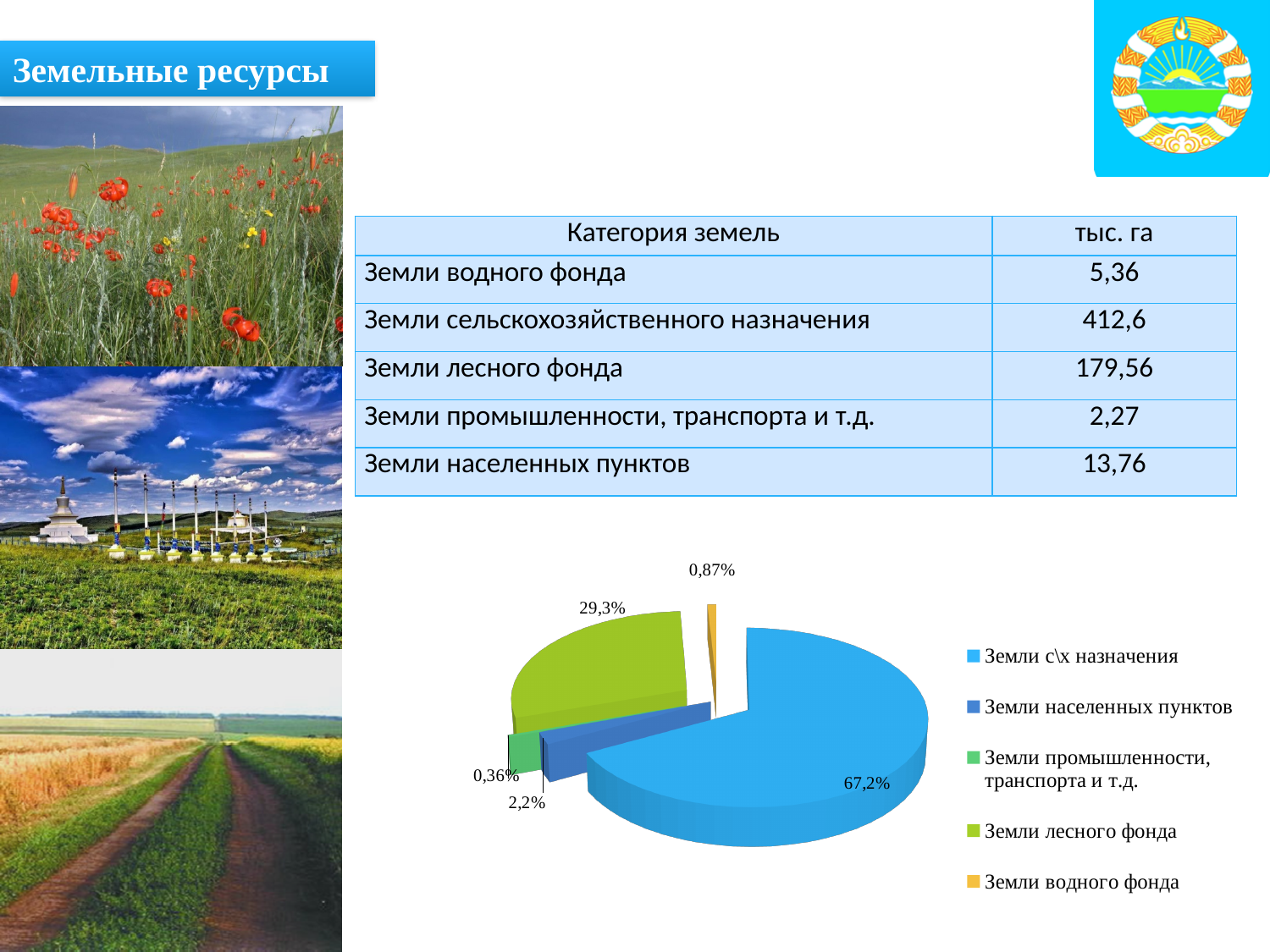
What colour is the "Земли лесного фонда" slice in the pie chart? green Which category has the smallest slice in the pie chart? Земли промышленности, транспорта и т.д. How many slices does the pie chart have? 5 What share of the pie chart does "Земли лесного фонда" have? 29,3% What share of the pie chart does "Земли водного фонда" have? 0,87% Which slice is larger in the pie chart: "Земли населенных пунктов" or "Земли водного фонда"? Земли населенных пунктов What kind of chart is shown on the slide? pie chart What share of the pie chart does "Земли промышленности, транспорта и т.д." have? 0,36% Which category has the largest slice in the pie chart? Земли с\х назначения What share of the pie chart does "Земли с\х назначения" have? 67,2% What share of the pie chart does "Земли населенных пунктов" have? 2,2% What is the difference in percentage points between the "Земли с\х назначения" slice and the "Земли лесного фонда" slice? 37,9